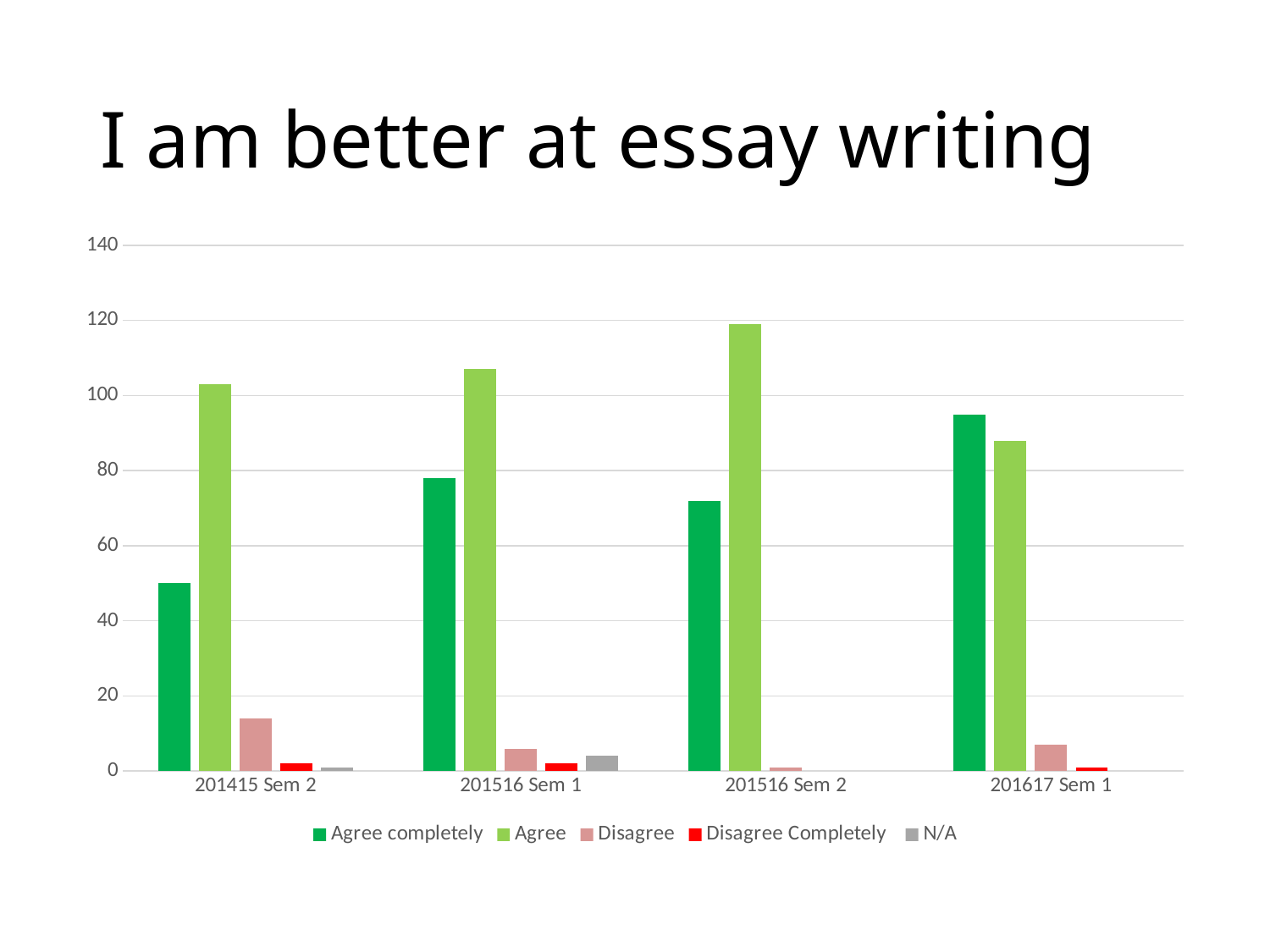
Which category has the highest value for Agree completely? 201617 Sem 1 How many categories are shown on the x axis? 4 Is the value for Agree completely in 201415 Sem 2 greater or less than 60? less How many series does the legend list? 5 What kind of chart is shown on the slide? bar chart In 201617 Sem 1, which is larger: Agree completely or Agree? Agree completely Which category has the lowest value for Agree completely? 201415 Sem 2 What colour represents the Disagree Completely series? red Does the value for Agree completely rise or fall from 201415 Sem 2 to 201516 Sem 1? rise Which category has the larger Disagree value: 201415 Sem 2 or 201516 Sem 1? 201415 Sem 2 Which category has the highest value for Agree? 201516 Sem 2 Is the value for Agree in 201516 Sem 2 greater or less than 100? greater